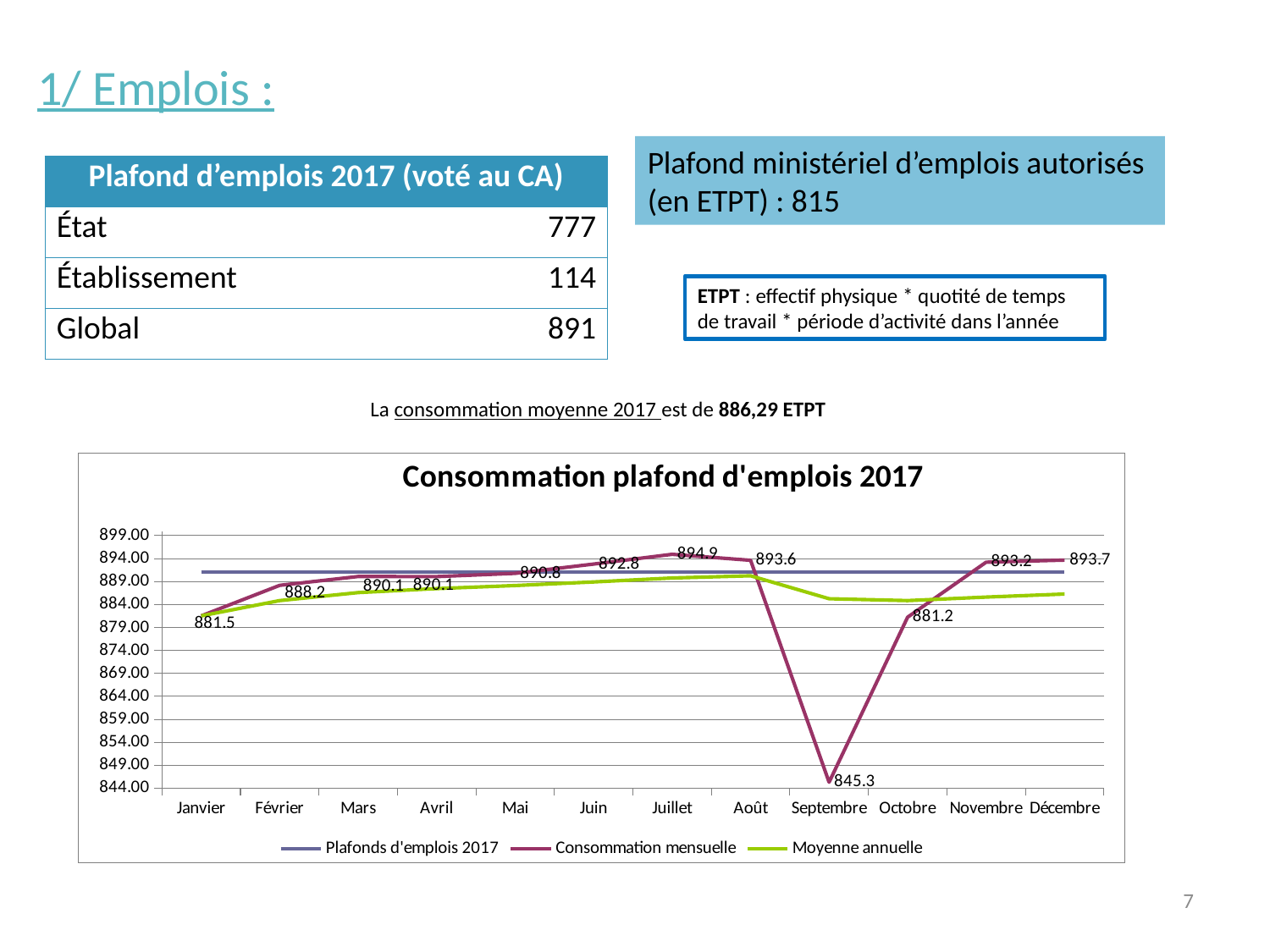
How many series does the legend list? 3 How many months are shown on the x axis? 12 In which month is Consommation mensuelle highest? Juillet What is the title of the chart? Consommation plafond d'emplois 2017 What is the value of Consommation mensuelle for Janvier? 881.5 In which month is Consommation mensuelle lowest? Septembre What is the value of Consommation mensuelle for Juillet? 894.9 Is the value of Moyenne annuelle for Septembre greater or less than 889.00? less Which is larger, Consommation mensuelle in Août or in Octobre? Août What is the difference between Consommation mensuelle in Décembre and in Janvier? 12.2 What kind of chart is this? line chart What is the value of Consommation mensuelle for Septembre? 845.3